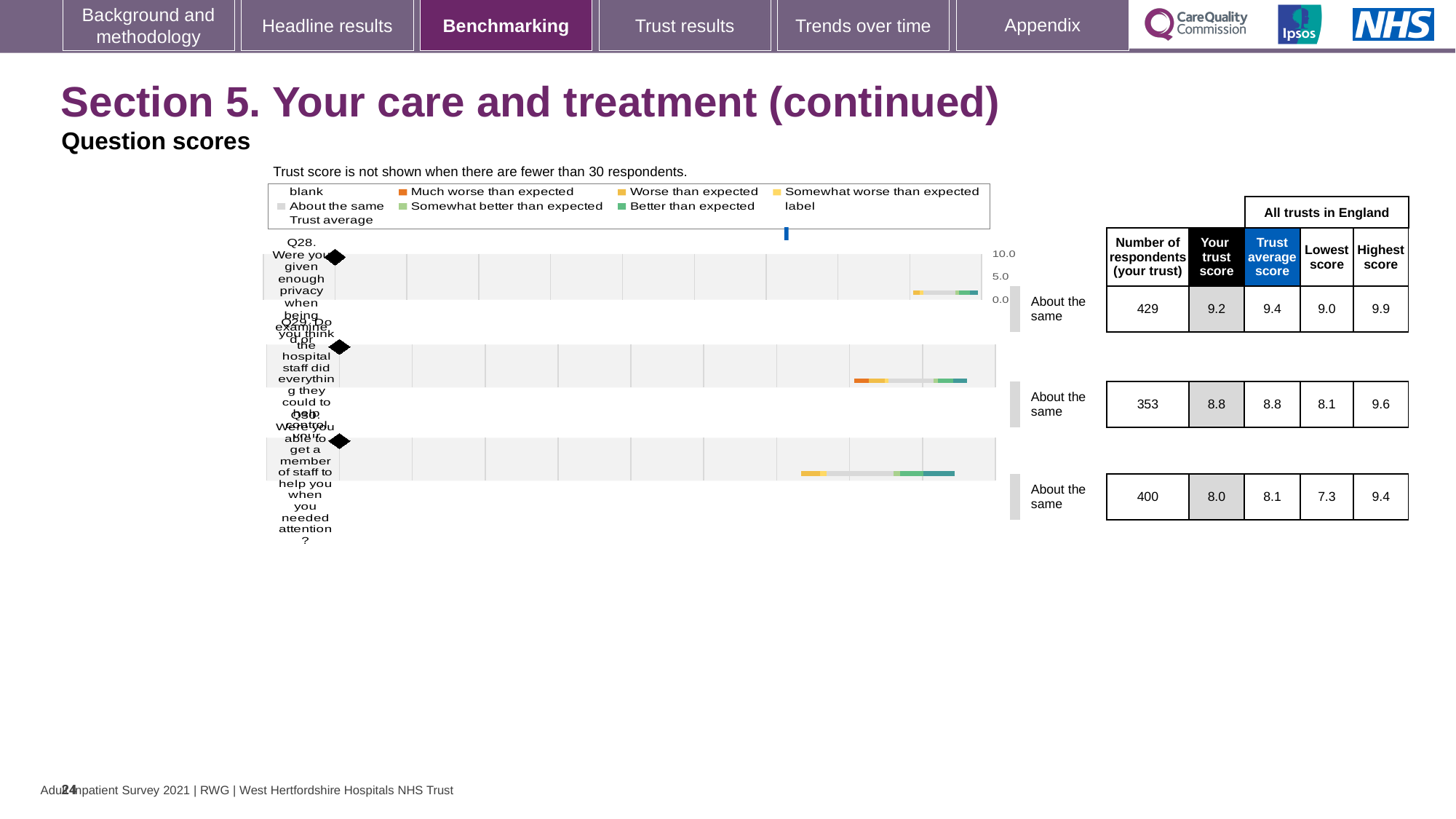
How many questions are plotted on the chart? 3 What benchmark category is shown for Q30? About the same What is the highest score across all trusts in England for Q28? 9.9 What is the maximum value shown on the chart's score axis? 10.0 Which question has the highest trust score on this slide? Q28 What is the difference between the trust average score and this trust's score for Q28? 0.2 How many respondents answered Q30 (Were you able to get a member of staff to help you when you needed attention?) at this trust? 400 What is the lowest score across all trusts in England for Q30? 7.3 What is the trust score for Q28 (Were you given enough privacy when being examined or treated?)? 9.2 What is the trust average score for Q29 (Do you think the hospital staff did everything they could to help control your pain?)? 8.8 Which question has the lowest trust score on this slide? Q30 For Q29, is this trust's score higher than, lower than, or the same as the trust average score? the same